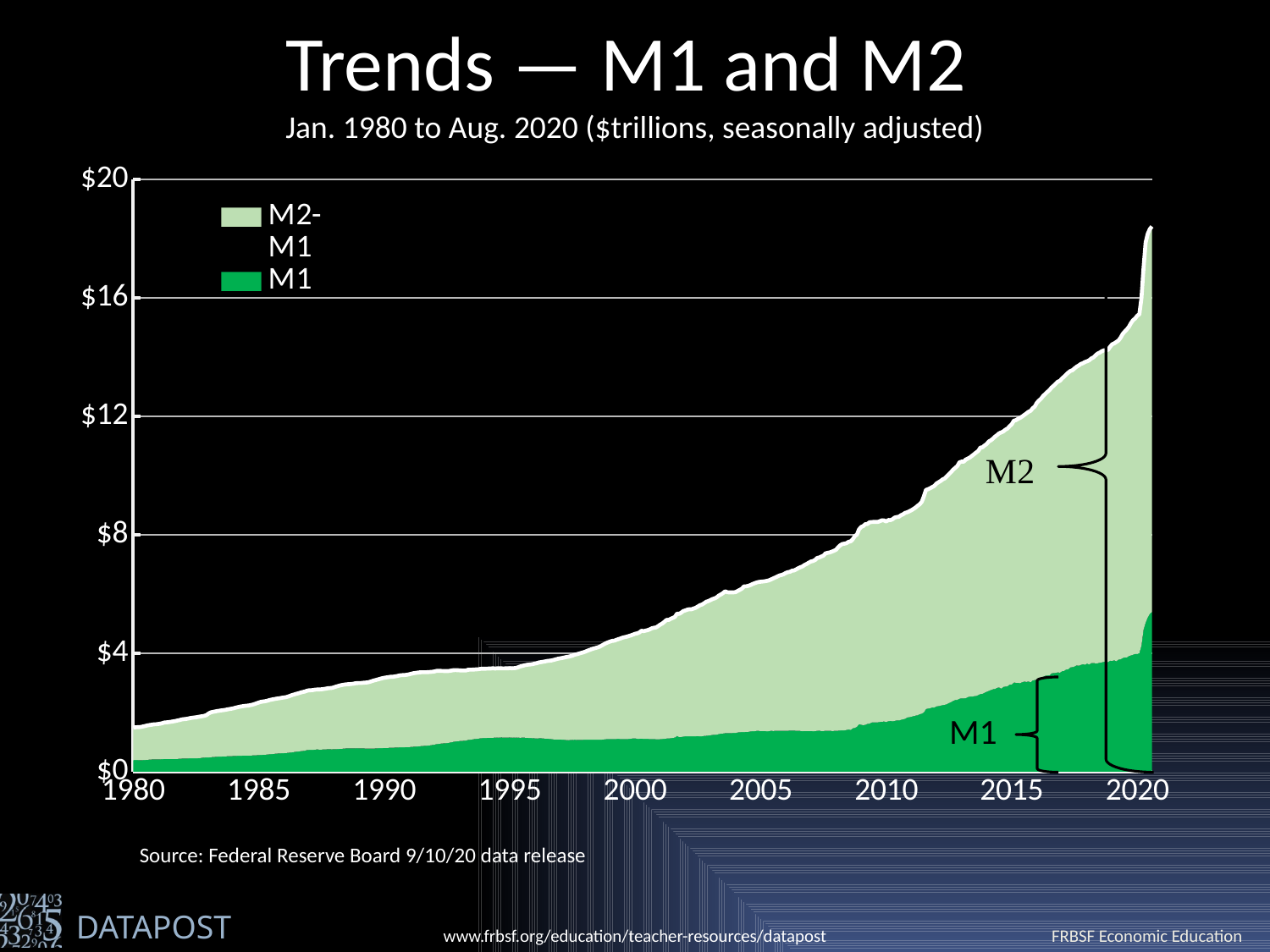
Is the value of M1 in 2010 greater or less than $4 trillion? less Is the value of M2 in 1990 greater or less than $4 trillion? less What is the title of the chart? Trends — M1 and M2 In 2020, which is larger: the M1 portion or the M2-M1 portion? M2-M1 What kind of chart is shown on the slide? Stacked area chart Is the value of M2 in 2000 greater or less than $4 trillion? greater What are the two series named in the legend? M2-M1 and M1 How many year labels are shown on the x axis? 9 Do the M2 values generally rise or fall from 1980 to 2020? Rise How many series does the legend list? 2